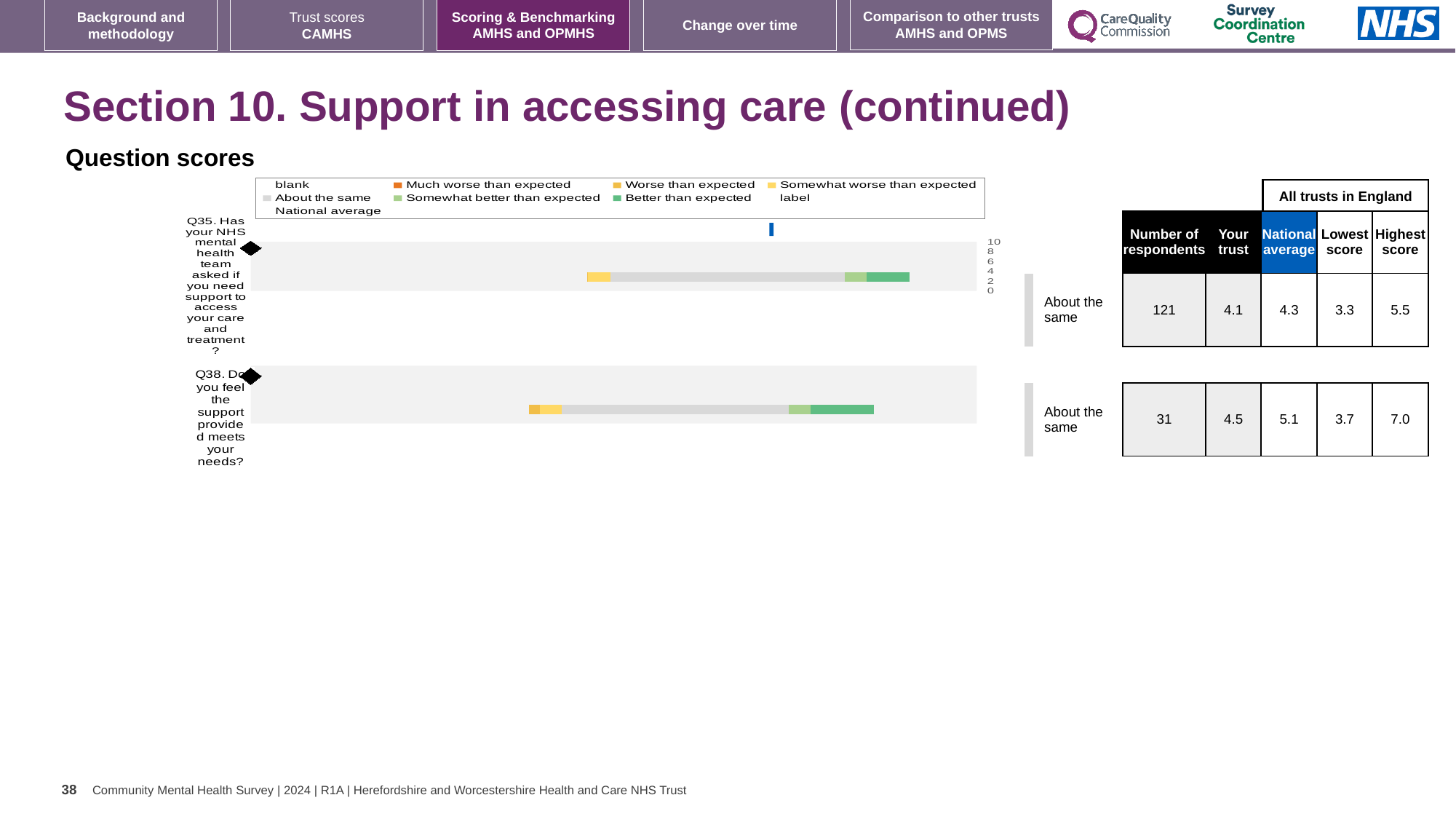
What is the highest score across all trusts in England for Q38? 7.0 What kind of chart is used to show the question scores on this slide? bar chart What is the difference between the highest score and the lowest score for Q35? 2.2 How many questions are plotted in the question scores chart? 2 By how much does the national average exceed the trust's score for Q38? 0.6 What does the blue marker in the chart legend represent? National average How many respondents answered Q35? 121 What is the national average score for Q38 (Do you feel the support provided meets your needs?)? 5.1 What benchmark category is shown for Q35? About the same What is the 'Your trust' score for Q35 (Has your NHS mental health team asked if you need support to access your care and treatment?)? 4.1 What is the lowest score across all trusts in England for Q38? 3.7 Which question has the higher 'Your trust' score, Q35 or Q38? Q38